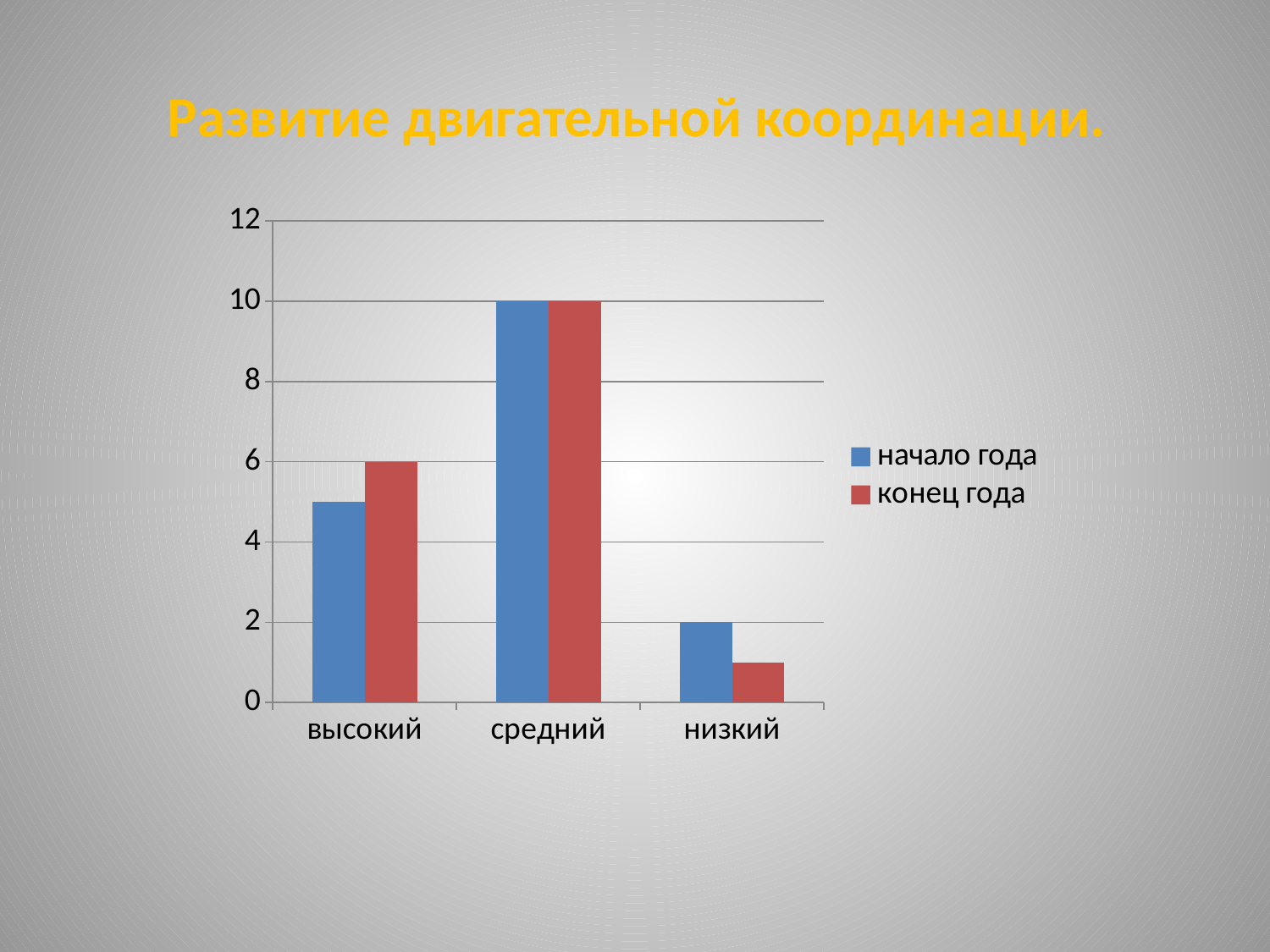
What is the difference between the конец года values for средний and высокий? 4 What is the value for средний in the конец года series? 10 How many categories are shown on the x axis? 3 What is the value for высокий in the конец года series? 6 Is the value for высокий in the начало года series greater or less than 4? greater What is the value for низкий in the начало года series? 2 Is the value for низкий in the конец года series greater or less than 2? less For низкий, which series has the larger value, начало года or конец года? начало года How many series does the legend list? 2 Which category has the lowest value in the конец года series? низкий What kind of chart is shown on the slide? bar chart Which category has the highest value in the начало года series? средний